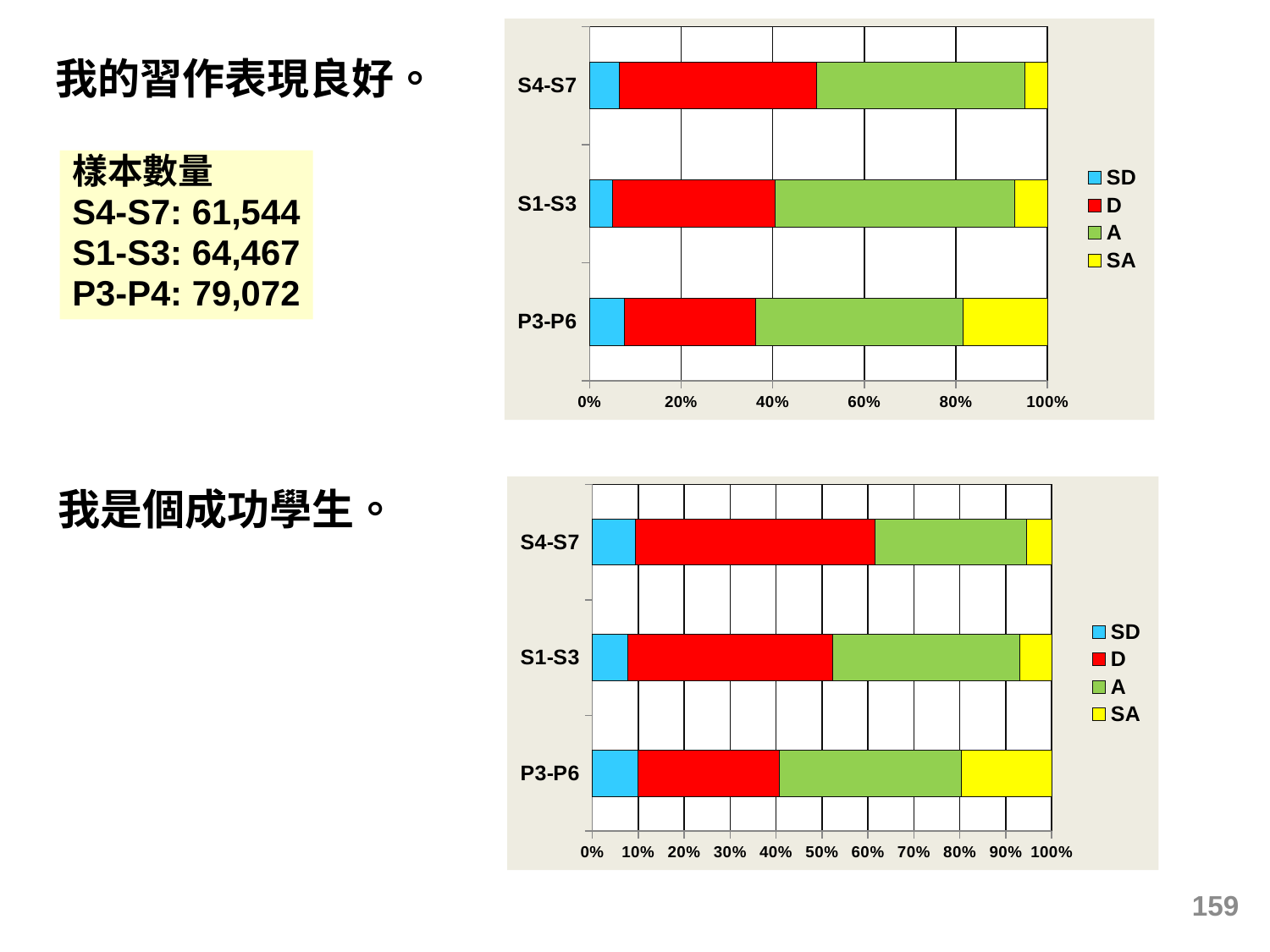
In the bottom chart, is the combined SD and D share for S4-S7 greater or less than 50%? greater In the top chart, which category has the largest SA (yellow) segment? P3-P6 How many series does the legend of the top chart list? 4 What is the highest value shown on the x axis of the bottom chart? 100% What kind of chart is the top chart on the slide? Stacked bar chart What are the legend entries of the bottom chart, from top to bottom? SD, D, A, SA In the top chart, is the combined SD and D share for S4-S7 greater or less than 40%? greater In the bottom chart, which category has the largest SA (yellow) segment? P3-P6 In the bottom chart, which category has the largest D (red) segment? S4-S7 In the top chart, is the D (red) segment larger for S4-S7 or for P3-P6? S4-S7 How many categories are shown on the y axis of the bottom chart? 3 In the bottom chart, is the combined SD and D share for P3-P6 greater or less than 50%? less